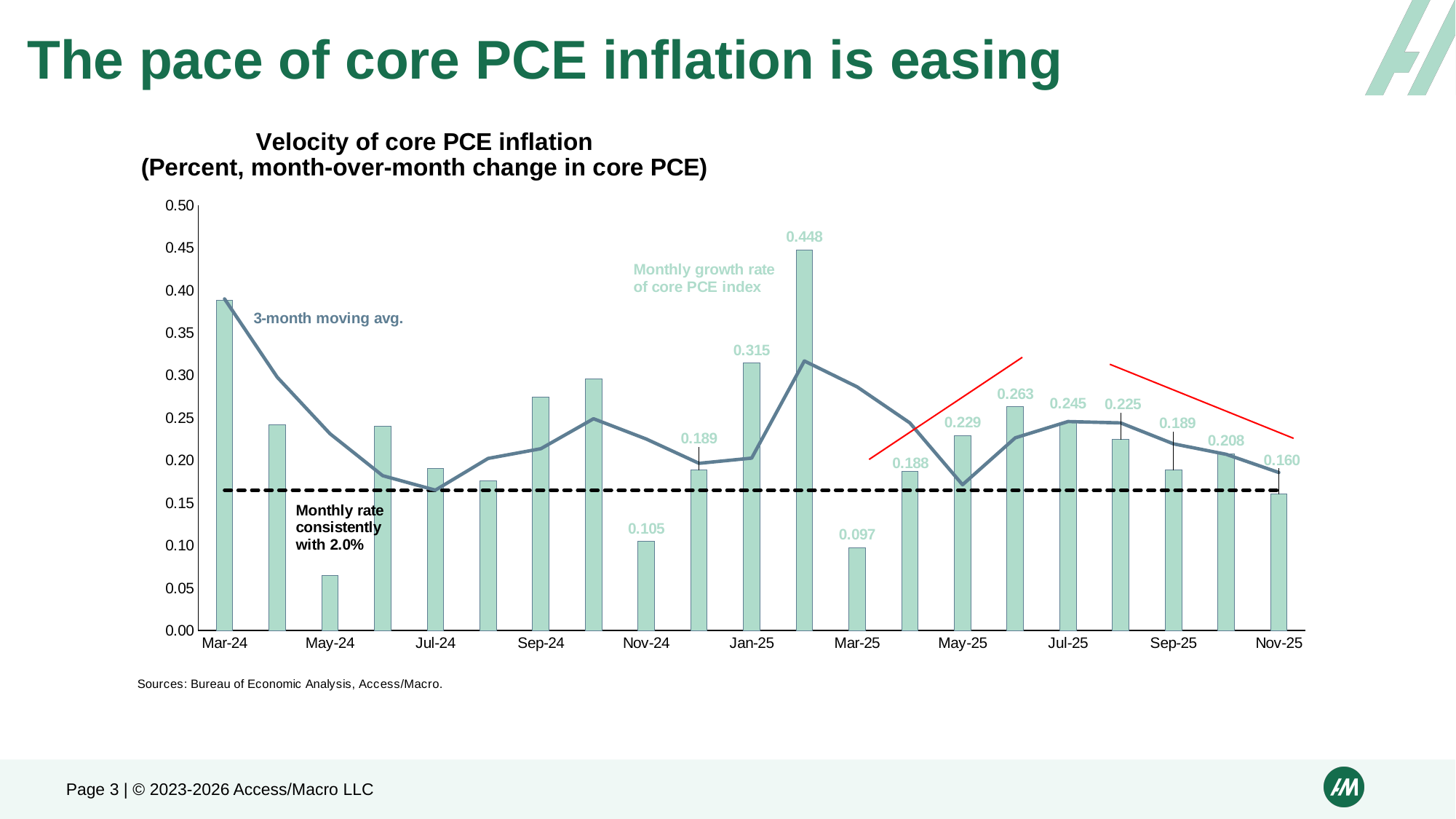
What does the solid line on the chart represent? 3-month moving avg. What is the monthly growth rate of the core PCE index for Mar-25? 0.097 What is the highest monthly growth rate value labelled on the chart? 0.448 What is the monthly growth rate of the core PCE index for Nov-24? 0.105 What is the monthly growth rate of the core PCE index for Jan-25? 0.315 Is the monthly growth rate bar for May-24 greater or less than 0.10? less What kind of chart is shown on the slide? Bar chart with a line What is the monthly growth rate of the core PCE index for Nov-25? 0.160 Is the monthly growth rate bar for Mar-24 greater or less than 0.35? greater What is the difference between the monthly growth rate for Jan-25 and Mar-25? 0.218 Which month has the larger monthly growth rate, May-25 or Jul-25? Jul-25 What is the difference between the monthly growth rate for Jul-25 and Sep-25? 0.056